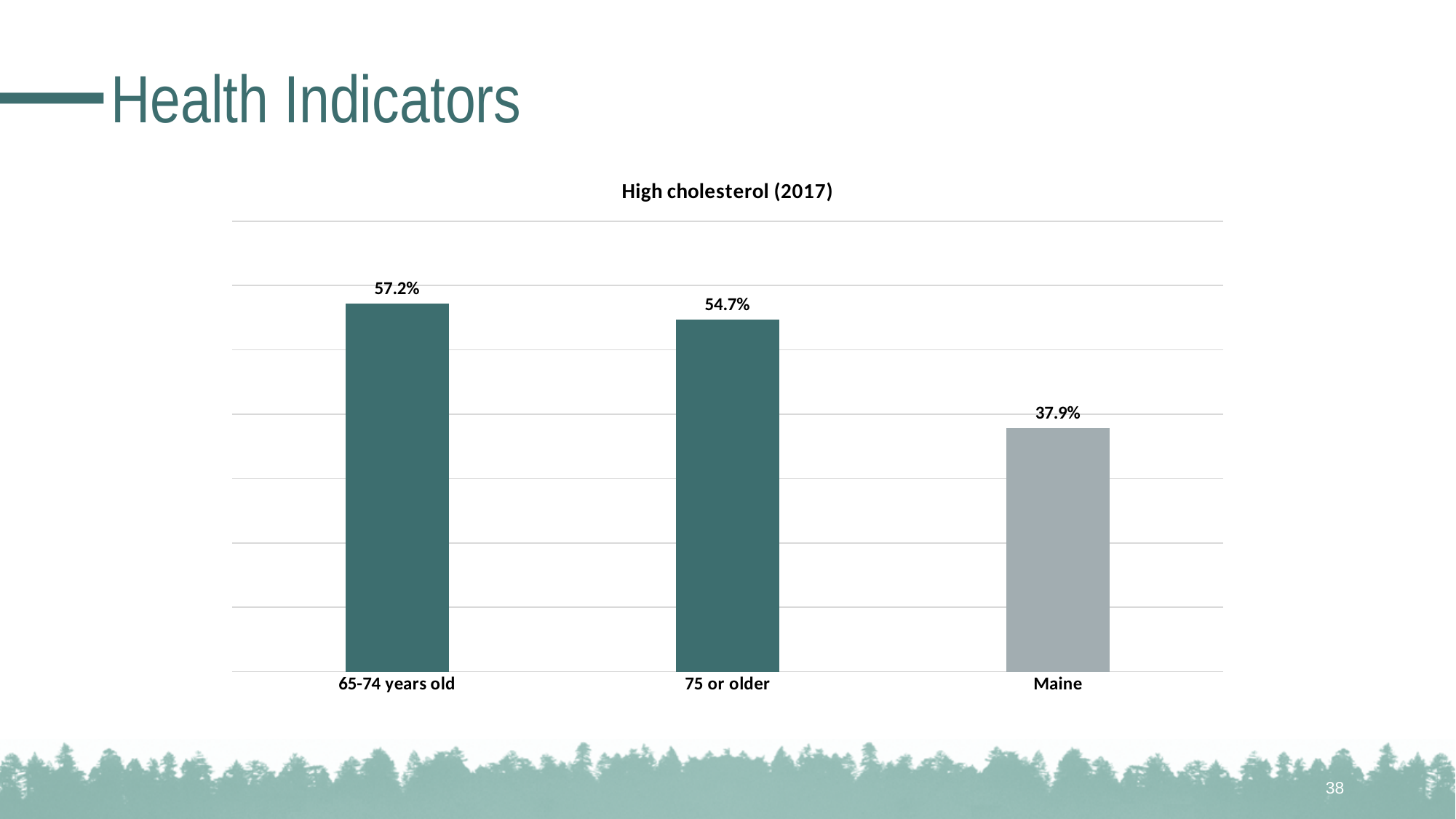
What is the value for Maine in the High cholesterol (2017) chart? 37.9% Which category has the lowest value in the High cholesterol (2017) chart? Maine What kind of chart is shown on the slide? Bar chart What is the value for 65-74 years old in the High cholesterol (2017) chart? 57.2% How many categories are shown in the High cholesterol (2017) chart? 3 Which is larger, the value for 75 or older or the value for Maine? 75 or older What is the difference between the values for 65-74 years old and 75 or older? 2.5% Which bar in the chart is coloured grey rather than teal? Maine What is the value for 75 or older in the High cholesterol (2017) chart? 54.7% What is the difference between the values for 65-74 years old and Maine? 19.3% What is the title of the chart on the slide? High cholesterol (2017) Which category has the highest value in the High cholesterol (2017) chart? 65-74 years old